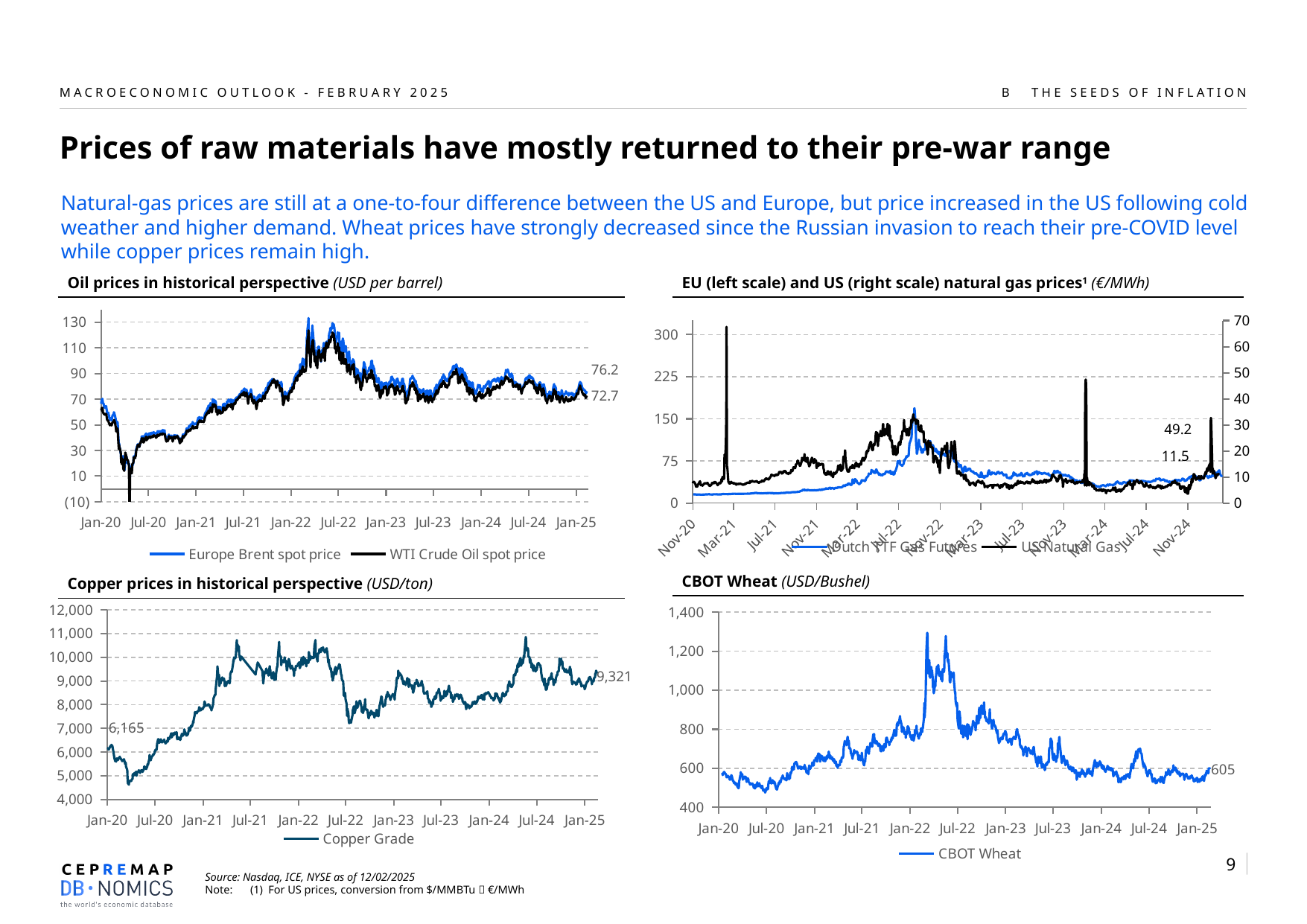
On the 'Oil prices in historical perspective' chart, which series has the higher latest value, Europe Brent or WTI Crude Oil? Europe Brent spot price On the 'CBOT Wheat' chart, what is the latest value shown? 605 On the 'Oil prices in historical perspective' chart, what is the difference between the latest Brent value and the latest WTI value? 3.5 How many series does the legend of the 'Oil prices in historical perspective' chart list? 2 What kind of chart is the 'CBOT Wheat' chart? Line chart On the 'EU (left scale) and US (right scale) natural gas prices' chart, what is the latest value shown for Dutch TTF Gas Futures? 49.2 On the 'Copper prices in historical perspective' chart, is the peak copper price greater or less than 10,000? greater On the 'Copper prices in historical perspective' chart, what is the latest value shown for Copper Grade? 9,321 On the 'Copper prices in historical perspective' chart, what is the value labelled at the start of the series in Jan-20? 6,165 On the 'Oil prices in historical perspective' chart, what is the latest value shown for the Europe Brent spot price? 76.2 On the 'EU (left scale) and US (right scale) natural gas prices' chart, what is the latest value shown for US Natural Gas? 11.5 On the 'Oil prices in historical perspective' chart, what is the latest value shown for the WTI Crude Oil spot price? 72.7